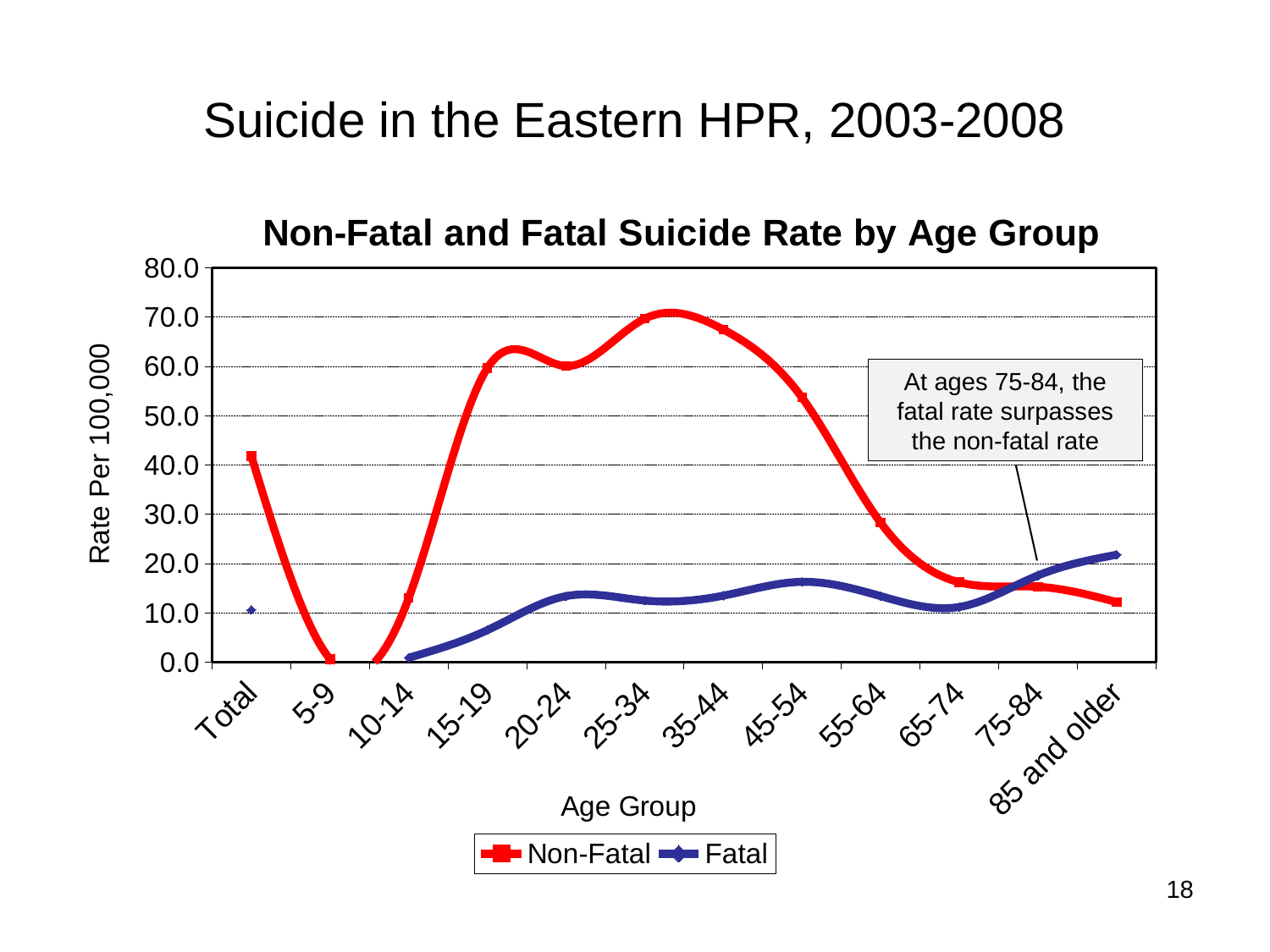
What colour is the Non-Fatal line? Red Is the Non-Fatal rate for 15-19 greater or less than 50.0? greater Which age group has the highest Fatal suicide rate? 85 and older At ages 75-84, which series has the higher rate, Non-Fatal or Fatal? Fatal Is the Fatal rate for 45-54 greater or less than 20.0? less Does the Fatal rate rise or fall from 65-74 to 85 and older? Rise Is the Non-Fatal rate for 55-64 greater or less than 40.0? less How many series does the legend list? 2 How many age group categories are shown on the x axis? 12 What kind of chart is shown on the slide? Line chart Which age group has the lowest Fatal suicide rate? 10-14